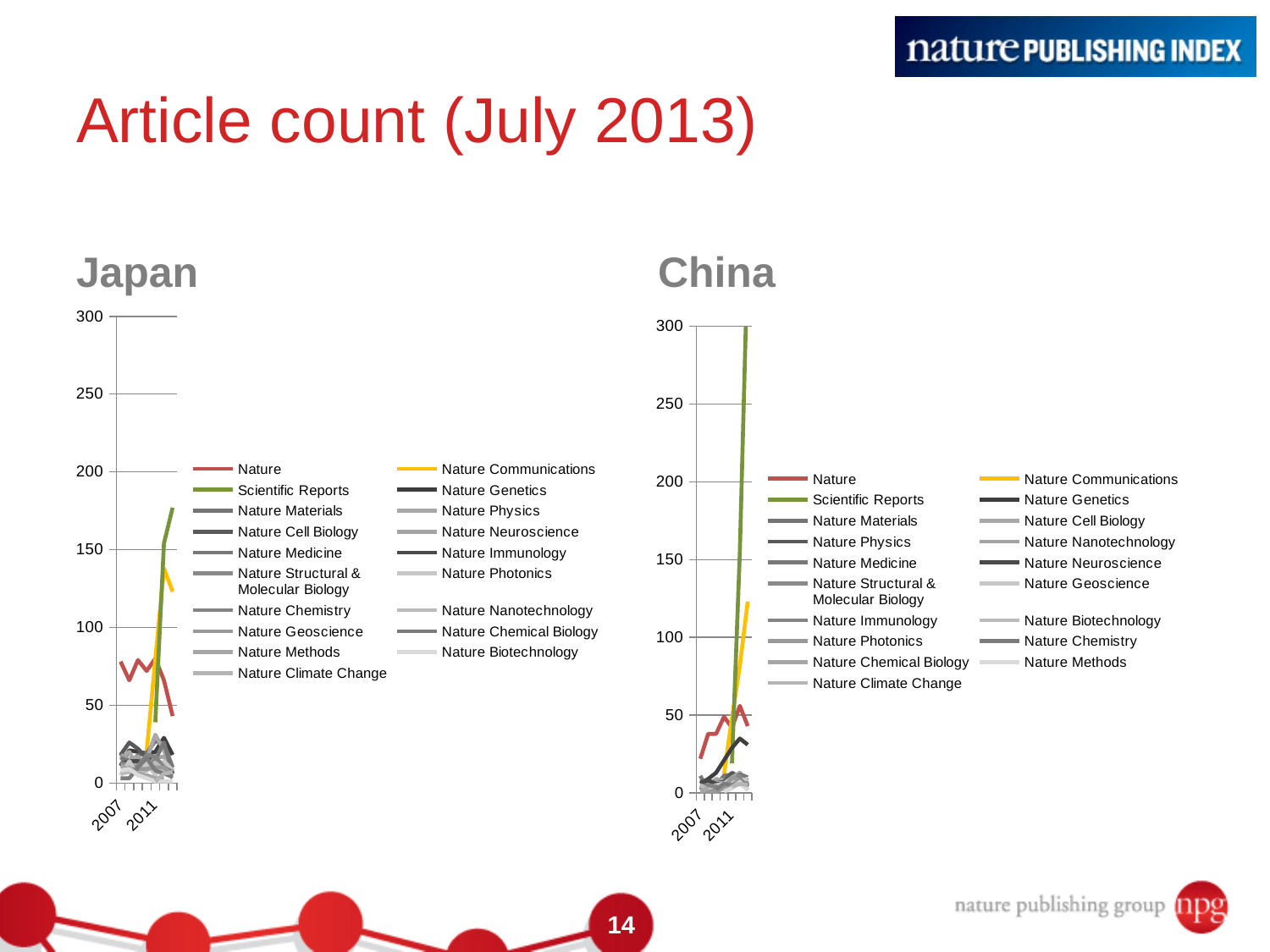
In the Japan chart, what colour is the Scientific Reports line in the legend? green In the Japan chart, which series reaches the highest value? Scientific Reports In the China chart, which series reaches the highest value? Scientific Reports How many series does the legend of the China chart list? 19 In the China chart, is the final value for Scientific Reports greater or less than 250? greater What kind of chart is the Japan chart? line chart In the China chart, at the latest point, which is larger: Scientific Reports or Nature? Scientific Reports In the China chart, does the Scientific Reports series rise or fall toward the end of the x axis? rise In the China chart, is the final value for Nature greater or less than 100? less In the Japan chart, is the final value for Nature Communications greater or less than 100? greater How many series does the legend of the Japan chart list? 19